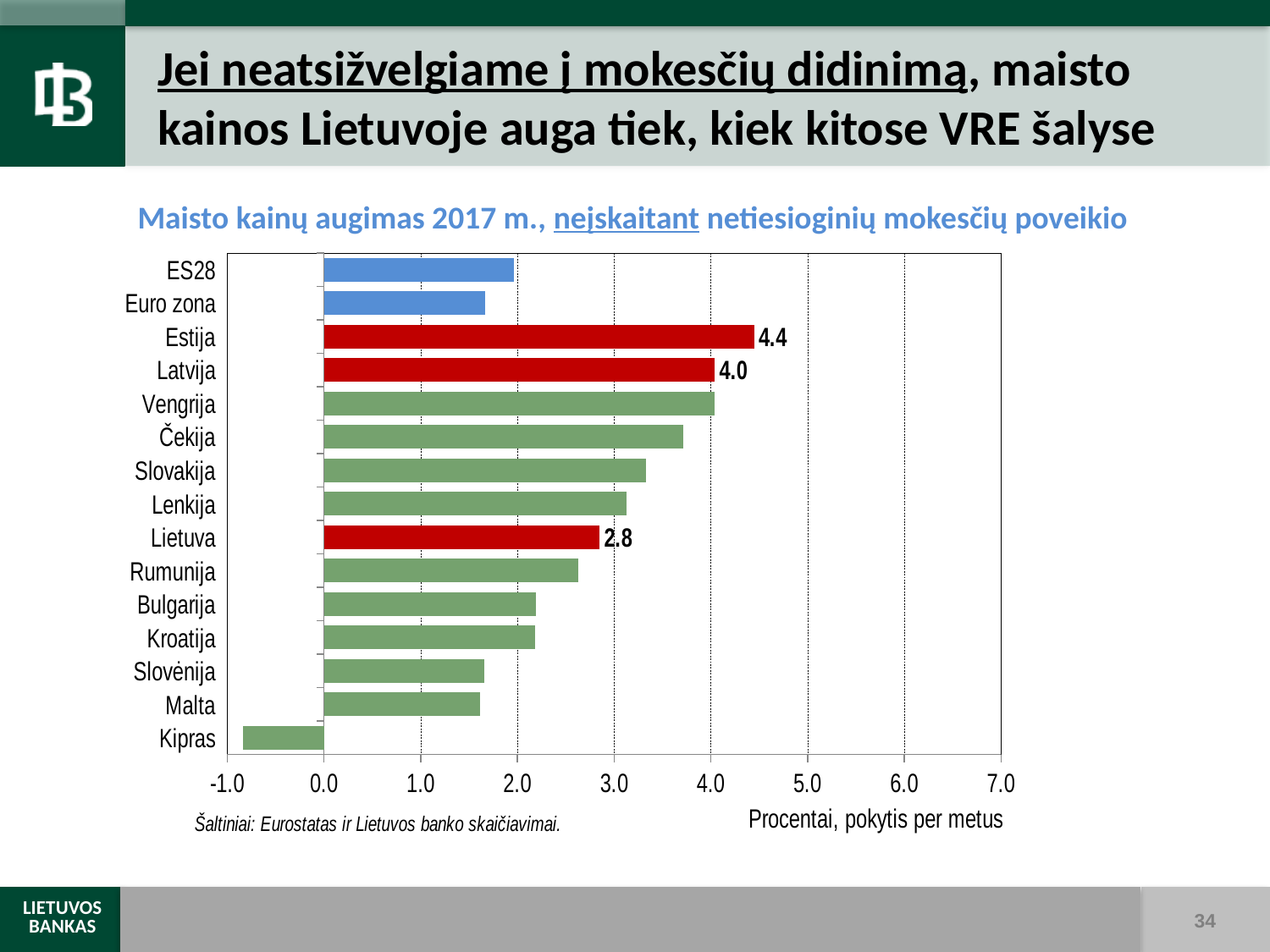
What is the value for Lietuva? 2.8 Which country has the lowest value in the chart? Kipras What type of chart is shown on the slide? bar chart What is the difference between the values for Estija and Lietuva? 1.6 Is the value for Kipras greater or less than 0.0? less Which country has the highest food price growth in the chart? Estija Which is larger, the value for Čekija or the value for Lietuva? Čekija What is the difference between the values for Estija and Latvija? 0.4 What is the value for Estija? 4.4 Is the value for Euro zona greater or less than 2.0? less How many countries or regions are shown in the chart? 15 What is the value for Latvija? 4.0